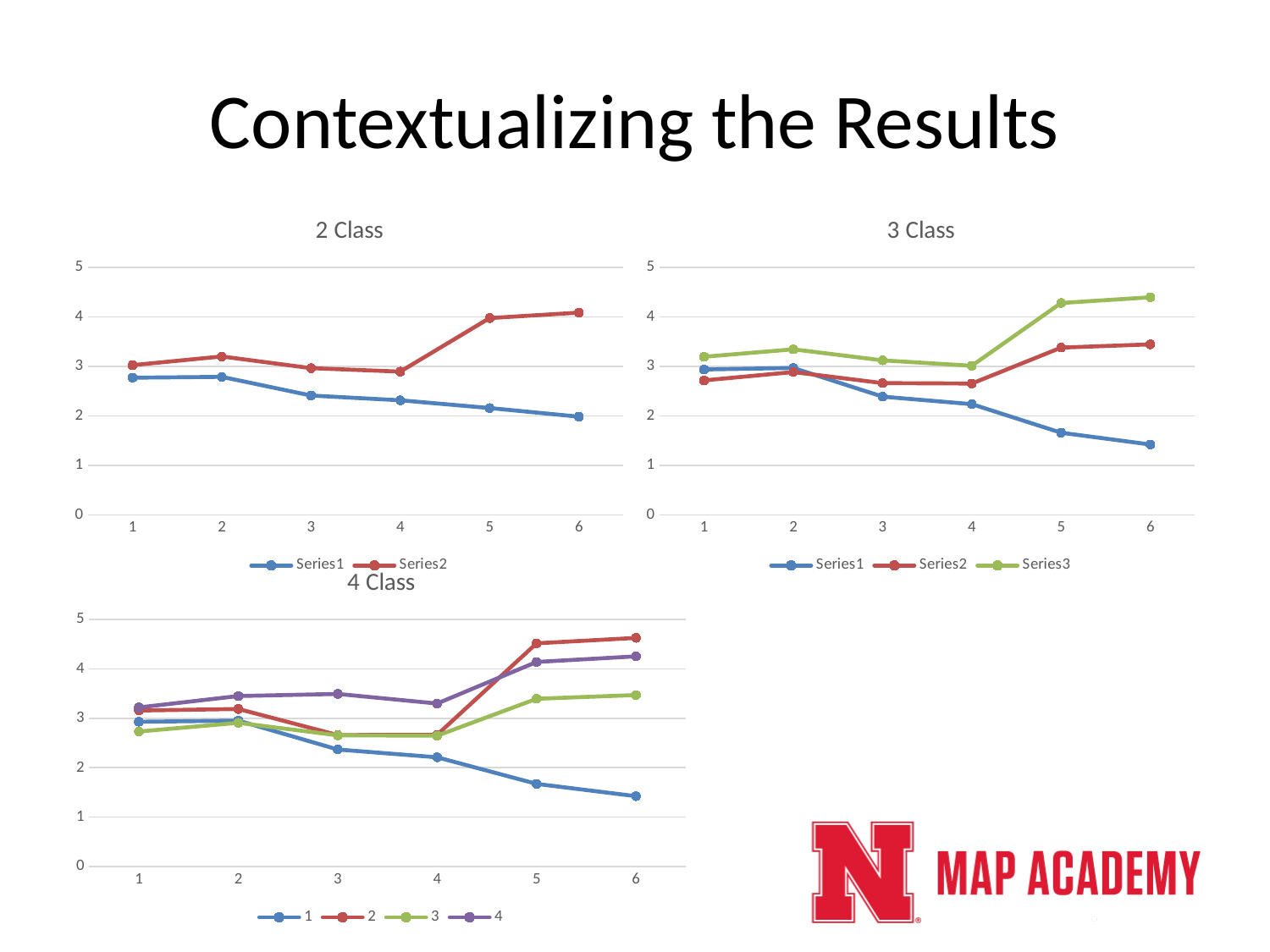
In the "4 Class" chart, which series has the lowest value at point 6? 1 In the "3 Class" chart, is the value of Series1 at point 6 greater or less than 2? less In the "2 Class" chart, does Series1 rise or fall from point 1 to point 6? fall In the "2 Class" chart, is the value of Series2 at point 6 greater or less than 4? greater In the "3 Class" chart, which is larger at point 5: Series1 or Series3? Series3 How many series does the legend of the "3 Class" chart list? 3 In the "2 Class" chart, does Series2 rise or fall from point 1 to point 6? rise How many series does the legend of the "4 Class" chart list? 4 In the "3 Class" chart, is the value of Series3 at point 6 greater or less than 4? greater How many points are plotted along the x axis of the "2 Class" chart for each series? 6 In the "4 Class" chart, which series has the highest value at point 6? 2 What kind of chart is the "2 Class" chart? line chart